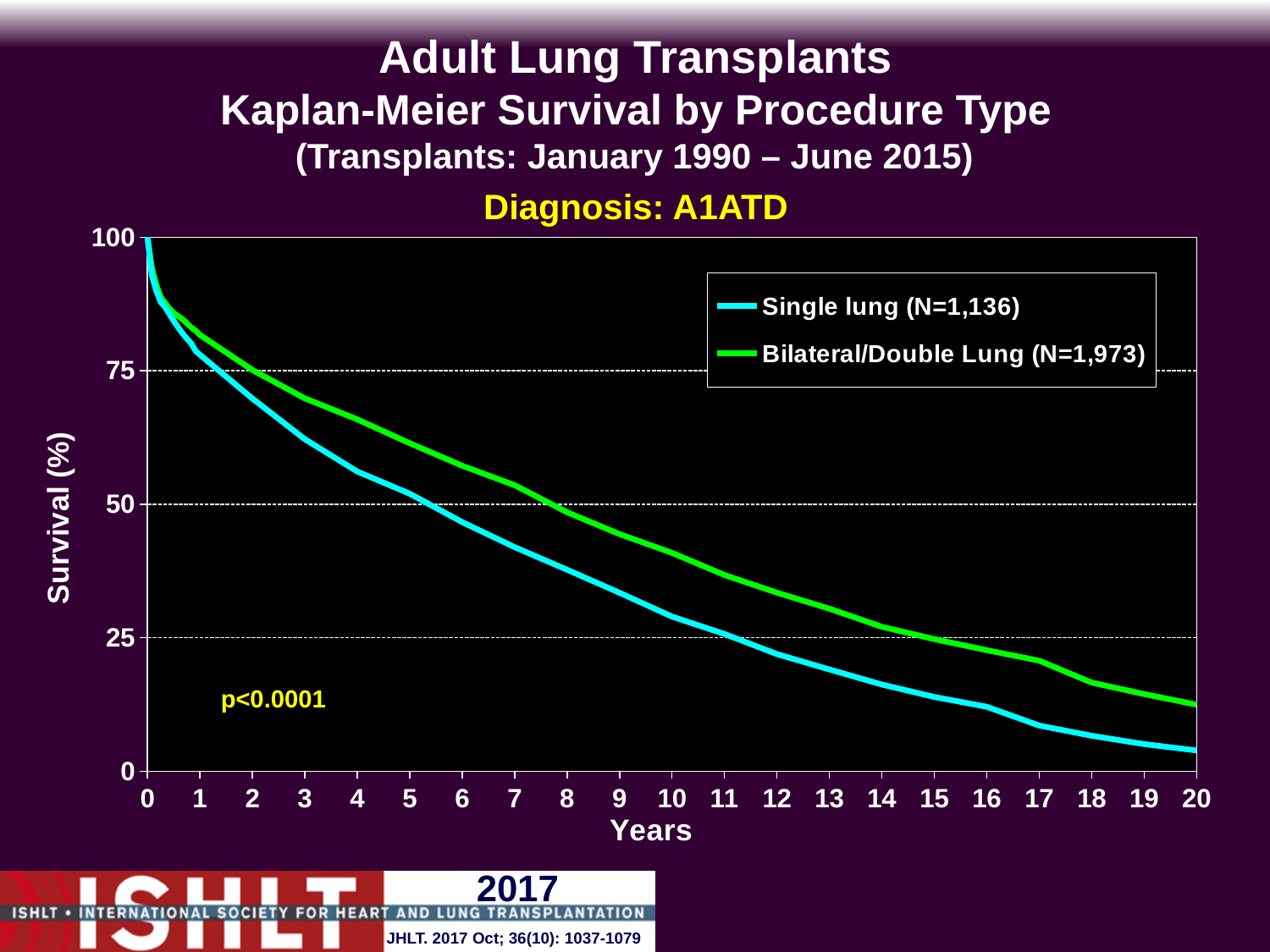
How many series does the legend list? 2 Do the survival curves rise or fall as years increase? fall Is the survival value for Bilateral/Double Lung at 20 years greater or less than 25? less What kind of chart is shown on the slide? line chart Is the survival value for Single lung at 1 year greater or less than 75? greater At 10 years, which procedure type has the higher survival, Single lung or Bilateral/Double Lung? Bilateral/Double Lung Is the survival value for Single lung at 15 years greater or less than 25? less What p-value is printed on the chart? p<0.0001 What is the N for the Single lung series shown in the legend? N=1,136